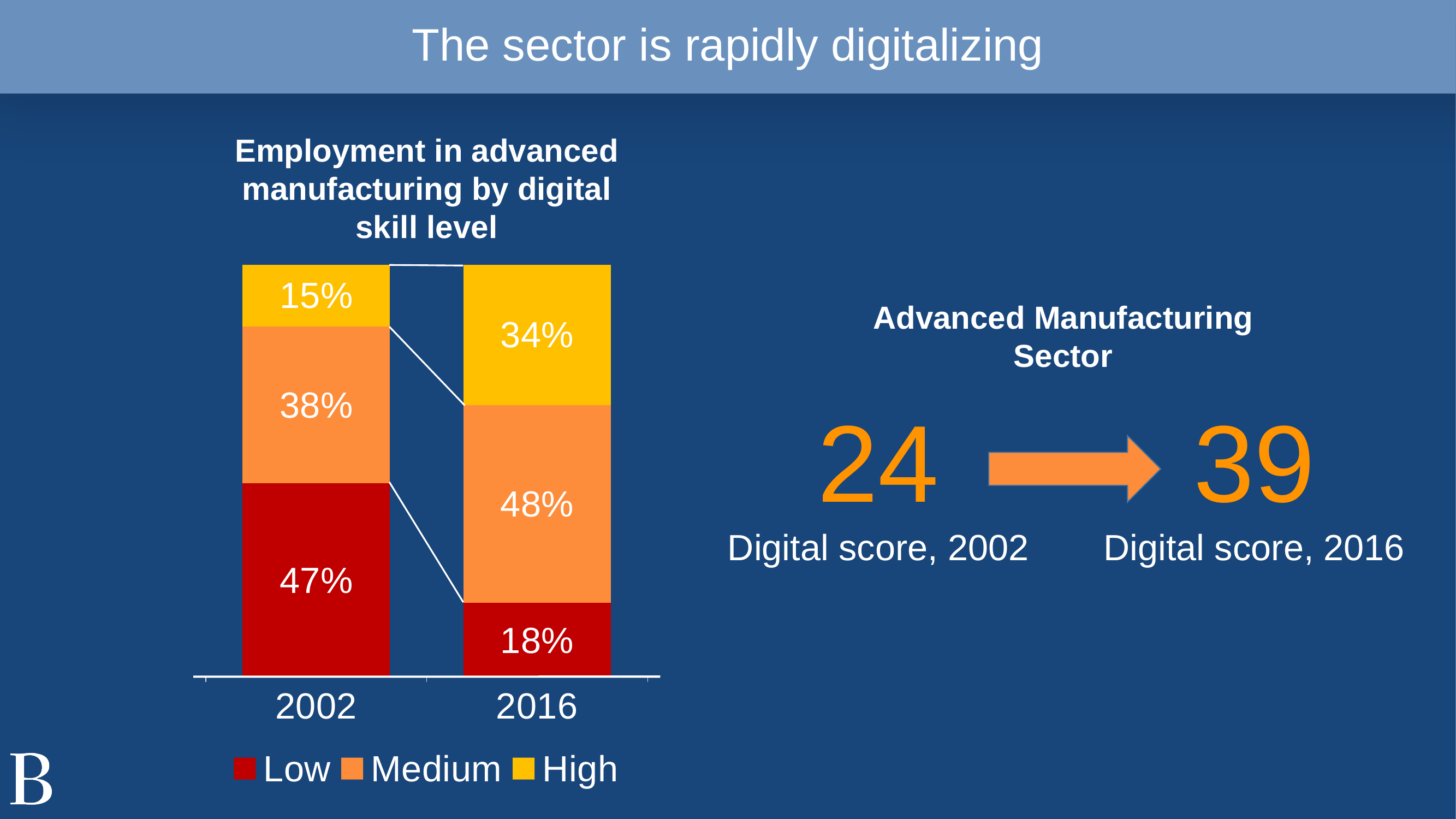
What is the title of the chart? Employment in advanced manufacturing by digital skill level What is the value for Low in 2002? 47% How many series does the chart legend list? 3 Which skill level has the smallest share in 2002? High What is the value for Low in 2016? 18% What is the value for Medium in 2002? 38% Does the Low share rise or fall from 2002 to 2016? Fall How many categories are shown on the x axis of the chart? 2 What kind of chart is shown on the slide? Stacked bar chart By how many percentage points did the High share change from 2002 to 2016? 19 percentage points What is the value for High in 2016? 34% Which skill level has the largest share in 2016? Medium